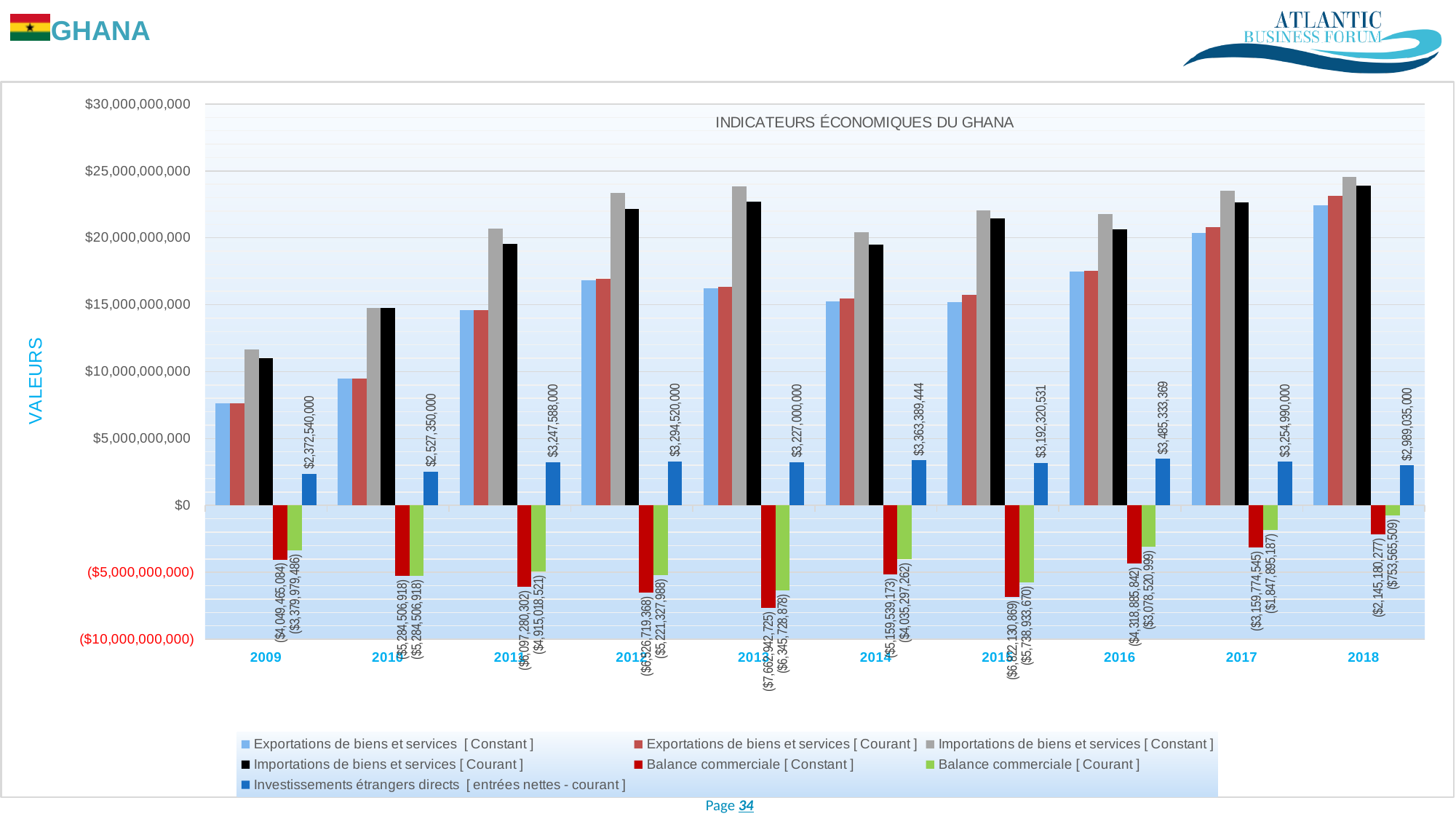
Is the value of Exportations de biens et services [Constant] for 2018 greater or less than $20,000,000,000? greater Which is larger, Investissements étrangers directs in 2010 or in 2011? 2011 What kind of chart is shown on the slide? Bar chart How many years are shown on the x axis of the chart? 10 What is the value of Balance commerciale [Courant] for 2018? ($753,565,509) What is the difference between Investissements étrangers directs in 2016 and in 2009? $1,112,793,369 Does Importations de biens et services [Constant] rise or fall from 2009 to 2013? rise What is the title of the chart? INDICATEURS ÉCONOMIQUES DU GHANA What is the value of Investissements étrangers directs [entrées nettes - courant] for 2016? $3,485,333,369 How many series does the chart's legend list? 7 In which year is Investissements étrangers directs [entrées nettes - courant] lowest? 2009 In which year is Investissements étrangers directs [entrées nettes - courant] highest? 2016